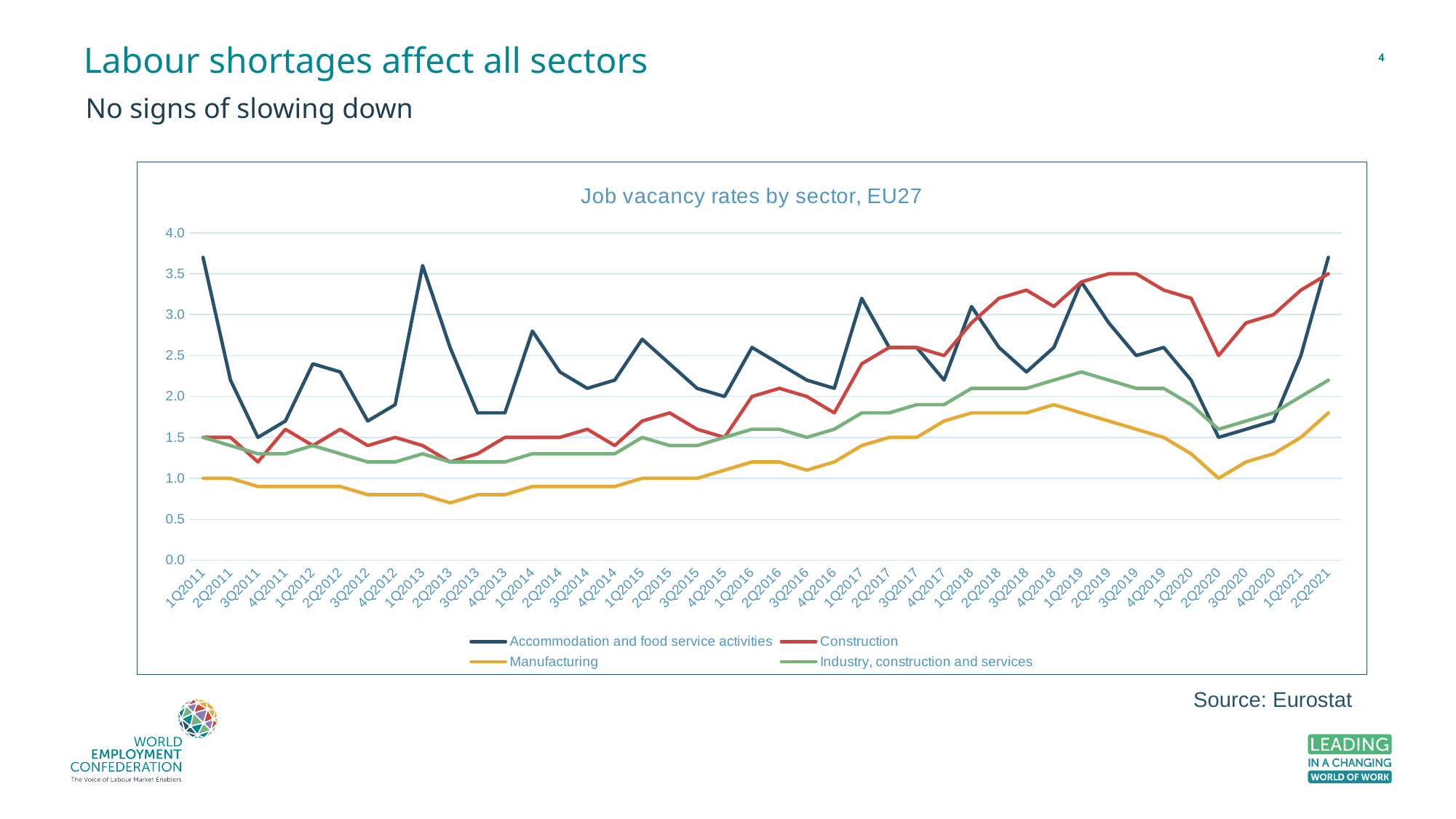
What is the Manufacturing job vacancy rate at 2Q2020? 1.0 How many quarters are plotted along the x axis of the chart? 42 At 1Q2018, which is larger: Construction or Manufacturing? Construction What kind of chart is shown on the slide? line chart Which series has the highest value at 2Q2021? Accommodation and food service activities How many series does the legend of the chart list? 4 Which series has the lowest values across the whole period? Manufacturing Is the Accommodation and food service activities value at 1Q2011 greater or less than 3.5? greater What is the source cited for the chart? Eurostat What is the Manufacturing job vacancy rate at 1Q2011? 1.0 Is the Manufacturing value at 2Q2013 greater or less than 1.0? less What is the title of the chart? Job vacancy rates by sector, EU27